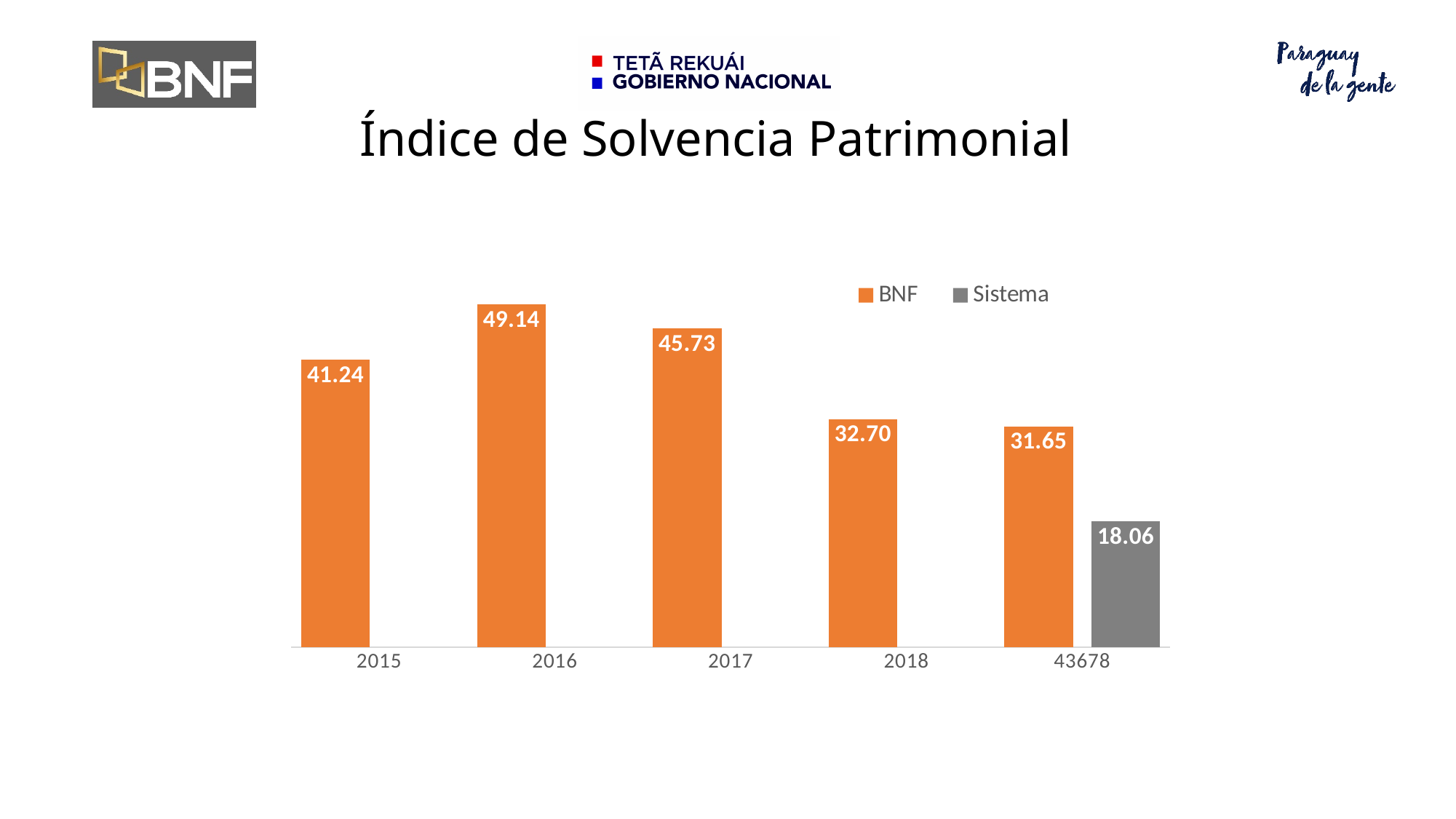
What is the BNF value for 2015? 41.24 How many series does the legend list? 2 Which category has the lowest BNF value? 43678 What is the BNF value for 2016? 49.14 In which year is the BNF value highest? 2016 What is the difference between the BNF values for 2016 and 2017? 3.41 Which is larger, the BNF value for 2015 or for 2018? 2015 What is the BNF value for 2018? 32.70 What type of chart is shown on the slide? Bar chart For the category labelled 43678, what is the difference between the BNF and Sistema values? 13.59 How many categories are shown on the x axis? 5 What is the Sistema value shown for the category labelled 43678? 18.06